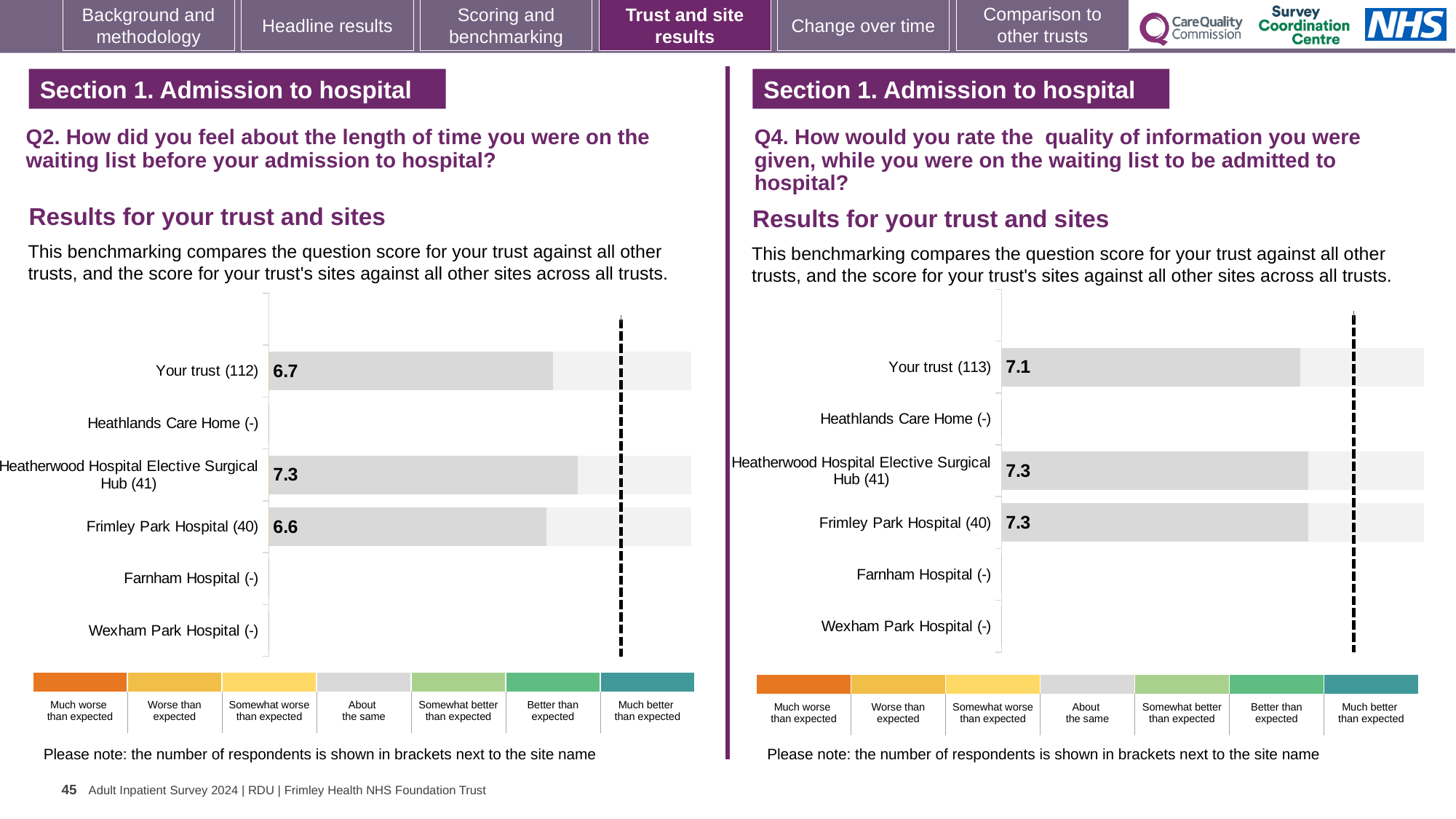
On the Q2 chart (left), which site with a plotted score has the lowest value? Frimley Park Hospital (40) On the Q4 chart (right), what is the score for Your trust (113)? 7.1 How many site/trust categories are listed on the Q2 chart (left)? 6 What kind of chart is the Q4 chart (right)? Bar chart On the Q2 chart (left), what is the difference between the scores for Heatherwood Hospital Elective Surgical Hub (41) and Frimley Park Hospital (40)? 0.7 On the Q2 chart (left), what is the score for Frimley Park Hospital (40)? 6.6 On the Q4 chart (right), what is the difference between the scores for Heatherwood Hospital Elective Surgical Hub (41) and Your trust (113)? 0.2 On the Q4 chart (right), what is the score for Frimley Park Hospital (40)? 7.3 On the Q2 chart (left), what is the score for Heatherwood Hospital Elective Surgical Hub (41)? 7.3 On the Q2 chart (left), which site with a plotted score has the highest value? Heatherwood Hospital Elective Surgical Hub (41) On the Q2 chart (left), what is the score for Your trust (112)? 6.7 On the Q4 chart (right), which is larger: the score for Your trust (113) or the score for Heatherwood Hospital Elective Surgical Hub (41)? Heatherwood Hospital Elective Surgical Hub (41)